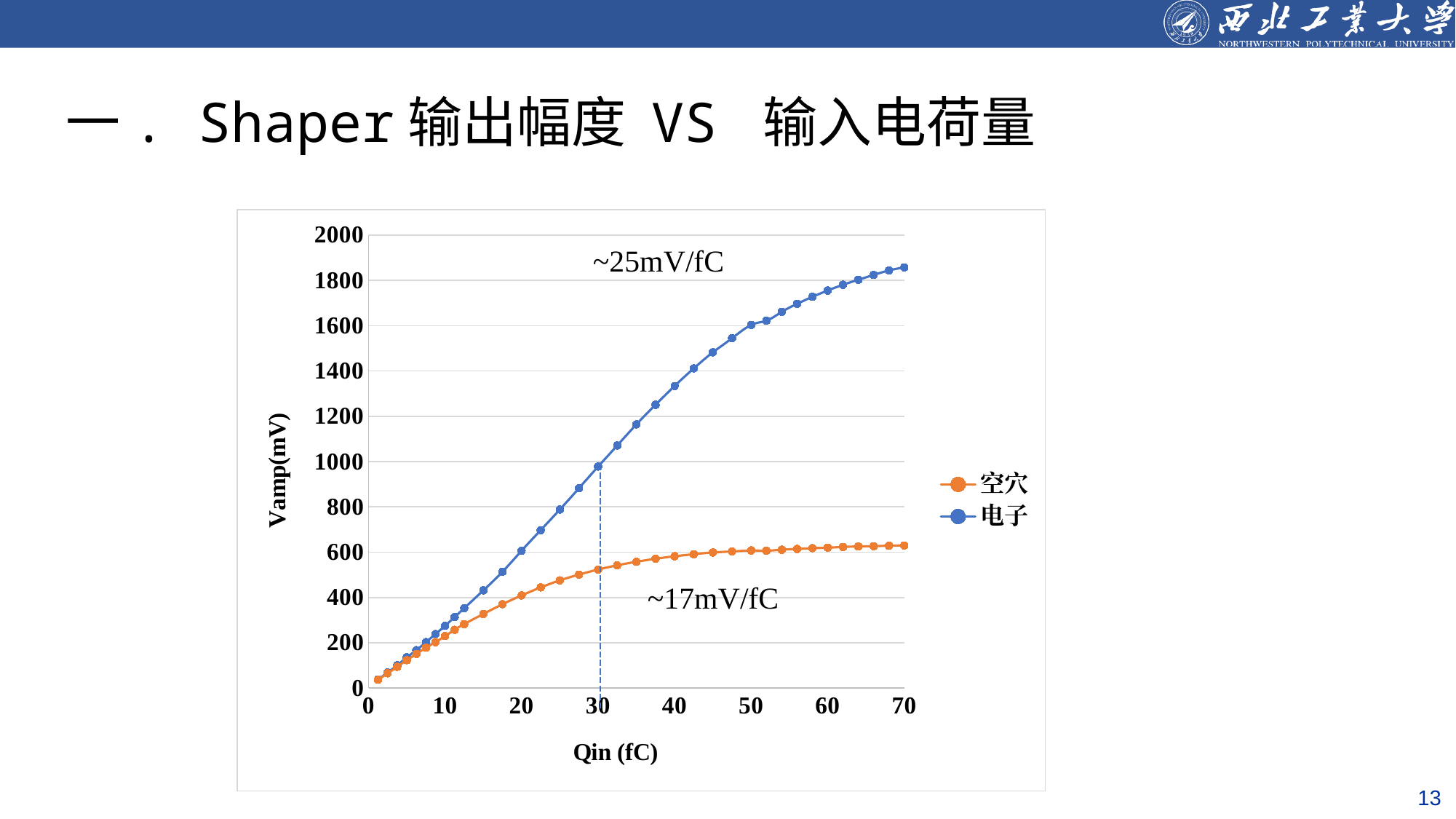
What is the title of the x axis? Qin (fC) Is the value for 电子 at Qin = 70 fC greater or less than 1600 mV? greater What kind of chart is shown on the slide? line chart Does the Vamp value for 空穴 rise or fall as Qin increases? rise How many series does the legend list? 2 What are the two series named in the legend? 空穴 and 电子 Does the Vamp value for 电子 rise or fall as Qin increases? rise Is the value for 电子 at Qin = 40 fC greater or less than 1200 mV? greater Is the value for 空穴 at Qin = 70 fC greater or less than 800 mV? less Which series has the higher Vamp value at Qin = 70 fC? 电子 Which series reaches the highest Vamp value on the chart? 电子